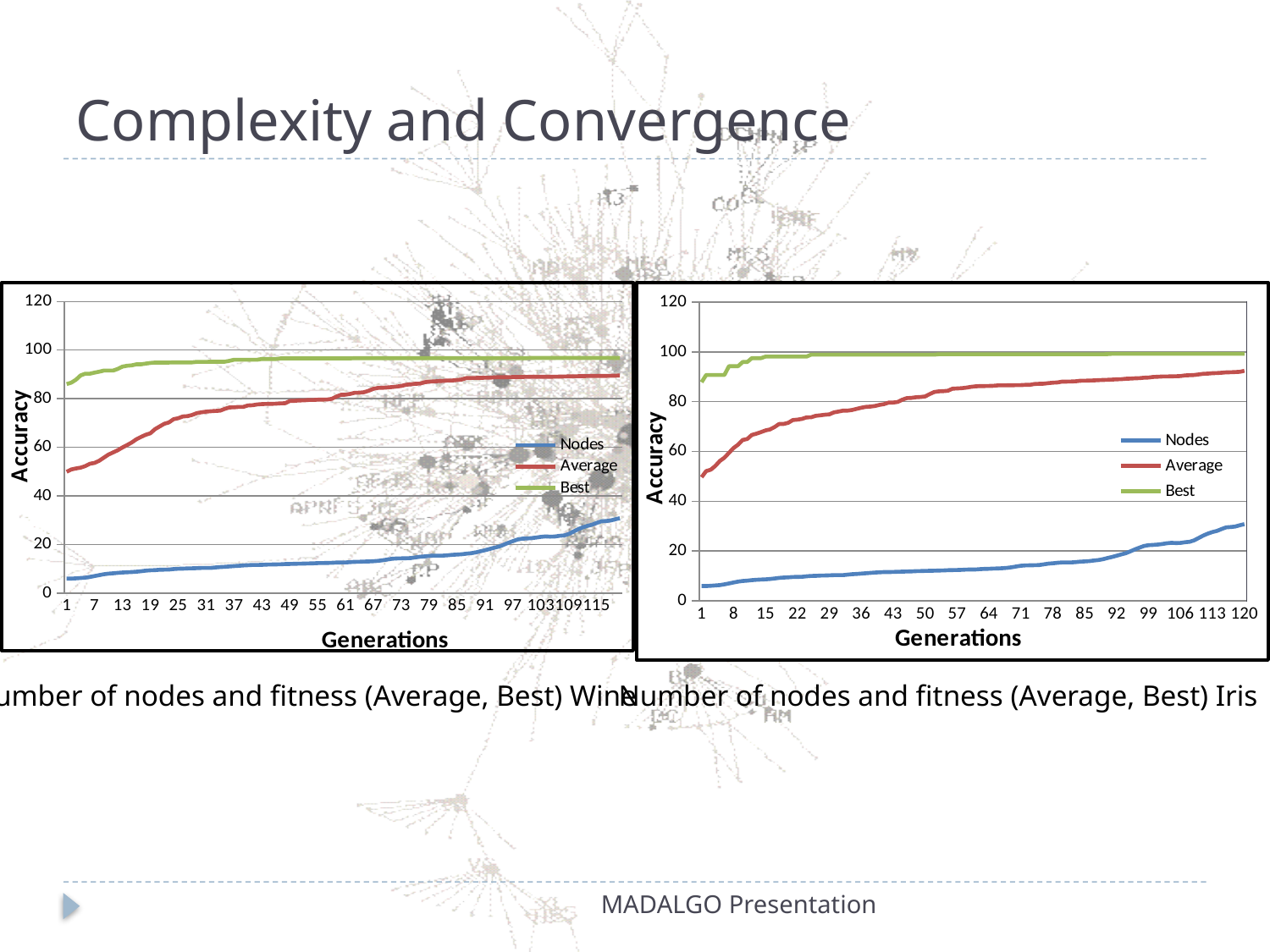
In the right chart, which series has the larger value at generation 1, Best or Nodes? Best What kind of chart is the left chart on the slide? line chart In the left chart, is the value of the Average series at generation 1 greater or less than 60? less What is the label of the vertical axis on the right chart? Accuracy In the left chart, does the Average series rise or fall as generations increase? rise In the right chart, is the value of the Best series at generation 120 greater or less than 80? greater In the left chart, which series has the lowest values across all generations? Nodes In the right chart, is the value of the Nodes series at generation 120 greater or less than 20? greater In the right chart, does the Nodes series rise or fall along the x axis? rise In the left chart, which series is shown in green according to the legend? Best How many series does the legend of the right chart list? 3